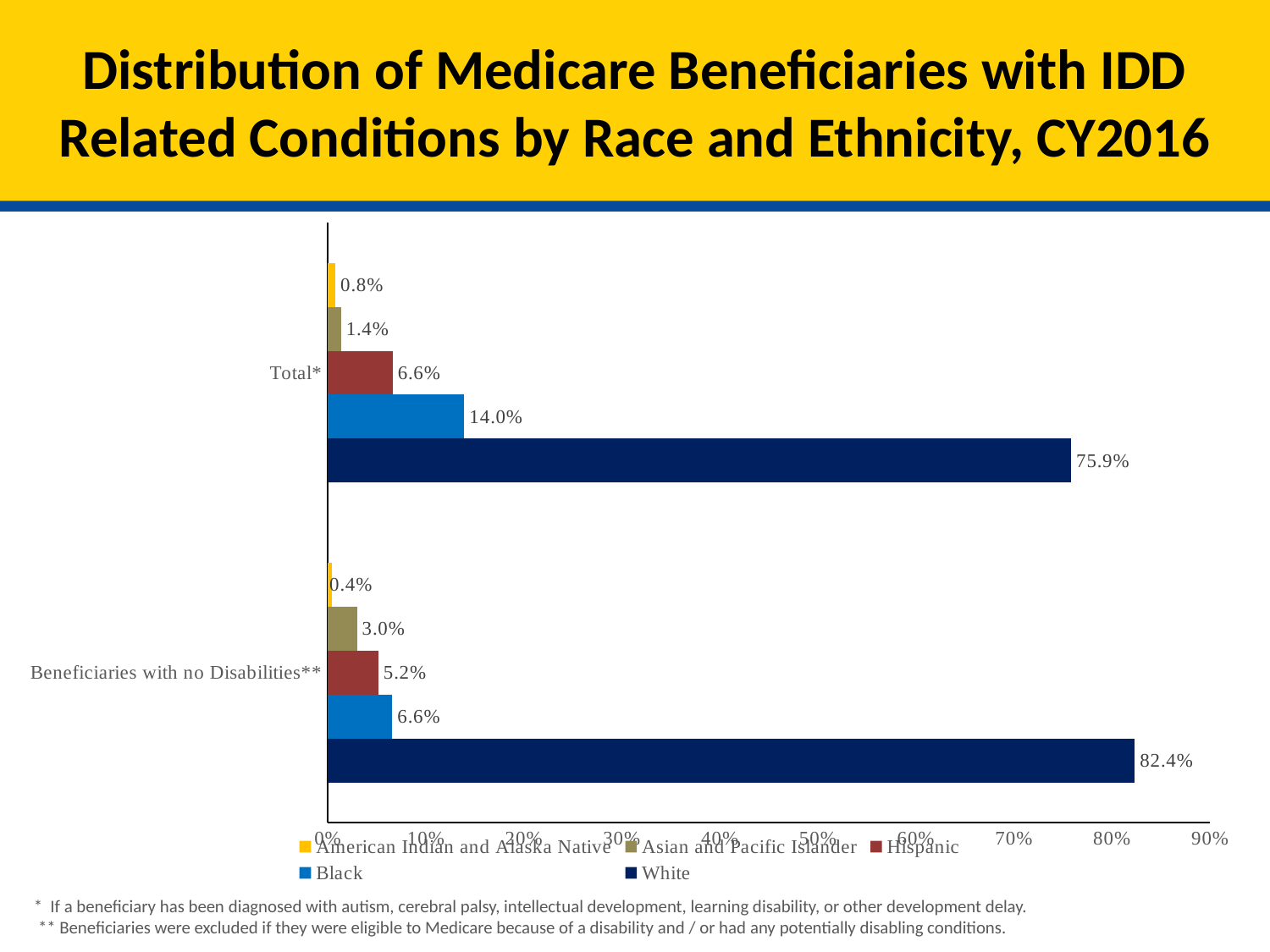
What is the value for Hispanic in the Total* category? 6.6% What is the value for White in the Total* category? 75.9% What kind of chart is shown on the slide? Bar chart What is the difference between the Asian and Pacific Islander values in the Beneficiaries with no Disabilities** and Total* categories? 1.6% Which race or ethnicity group has the highest value in the Total* category? White What is the value for Black in the Beneficiaries with no Disabilities** category? 6.6% How many categories are shown on the vertical axis? 2 What is the difference between the Black value in the Total* category and the Black value in the Beneficiaries with no Disabilities** category? 7.4% What is the value for American Indian and Alaska Native in the Beneficiaries with no Disabilities** category? 0.4% Is the White value larger in the Total* category or in the Beneficiaries with no Disabilities** category? Beneficiaries with no Disabilities** How many series does the legend list? 5 Which race or ethnicity group has the lowest value in the Beneficiaries with no Disabilities** category? American Indian and Alaska Native